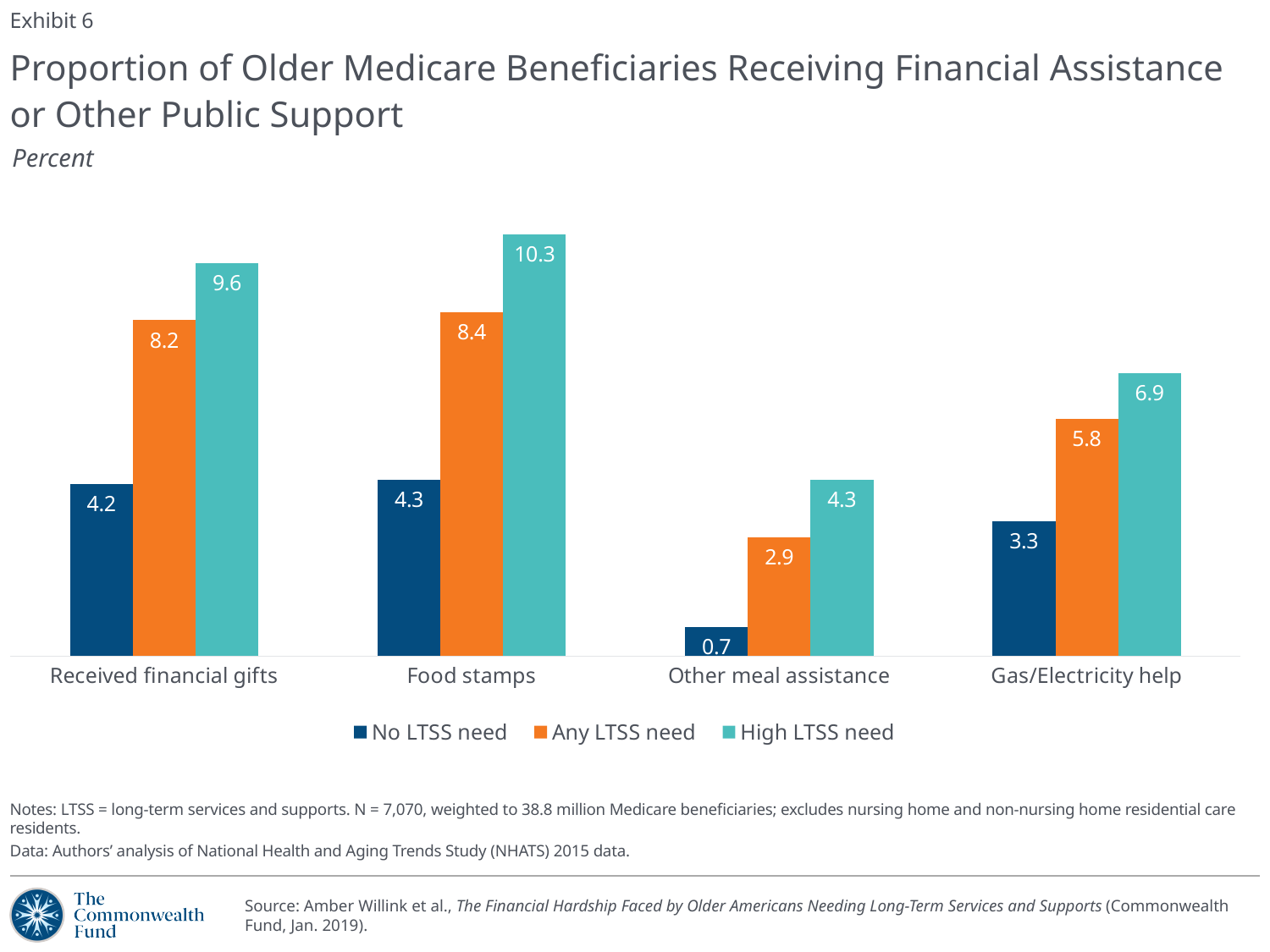
Which category has the lowest value for the No LTSS need series? Other meal assistance What is the value for High LTSS need in the Food stamps category? 10.3 Which series is shown in orange in the legend? Any LTSS need What is the difference between the Any LTSS need and No LTSS need values for Other meal assistance? 2.2 What kind of chart is shown on the slide? Bar chart What is the value for Any LTSS need in the Gas/Electricity help category? 5.8 What is the value for No LTSS need in the Other meal assistance category? 0.7 How many categories are shown on the x axis? 4 How many series does the legend list? 3 What is the difference between the High LTSS need and No LTSS need values for Received financial gifts? 5.4 Which category has the highest value for the High LTSS need series? Food stamps Which is larger: the Any LTSS need value for Food stamps or the Any LTSS need value for Received financial gifts? Food stamps